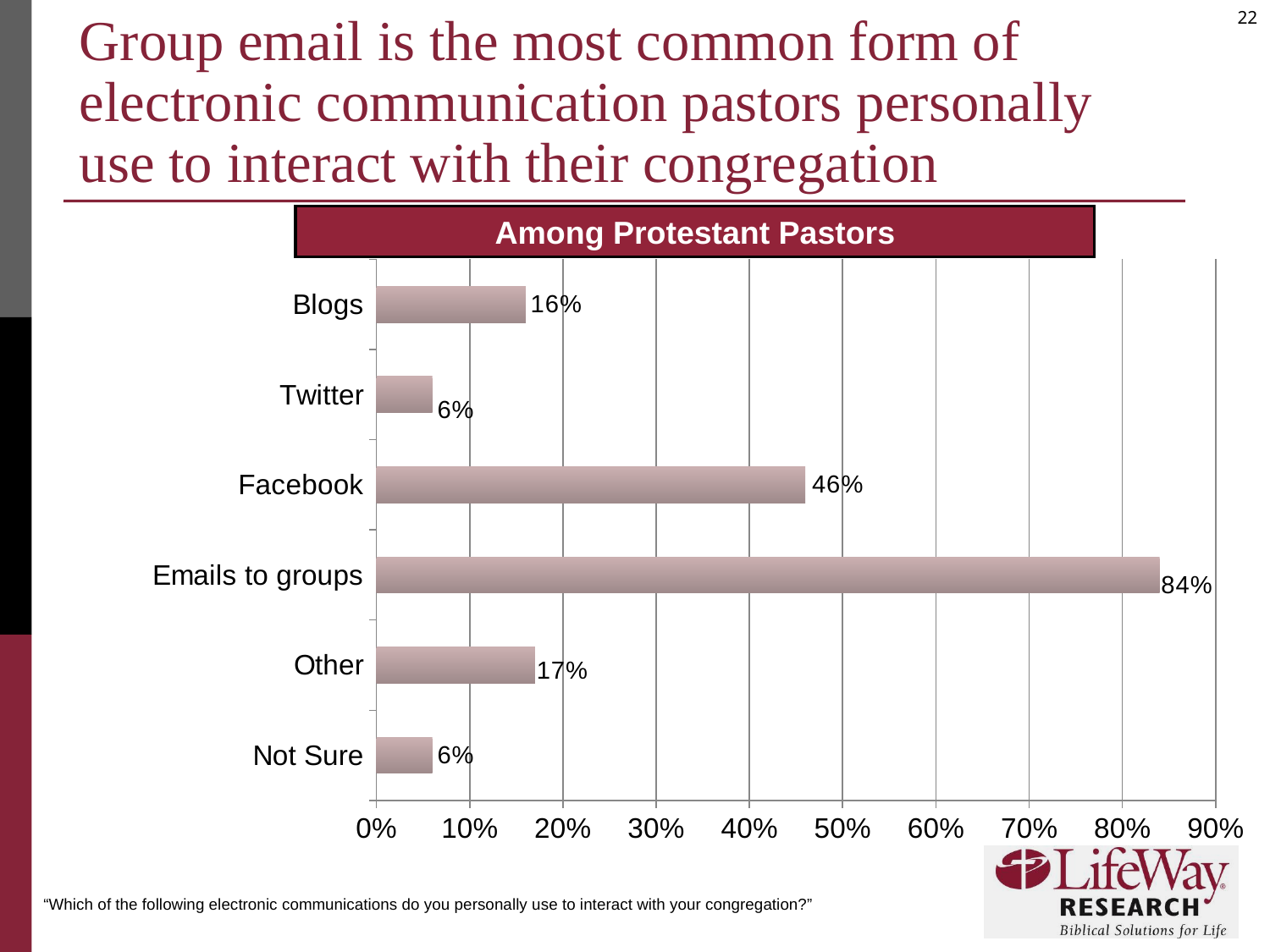
What kind of chart is shown on the slide? Bar chart Which is larger, the value for Facebook or the value for Blogs? Facebook What is the value shown for Blogs? 16% How many categories are shown in the chart? 6 What percentage of Protestant pastors use emails to groups? 84% Is the value for Facebook greater or less than 50%? less What is the title shown above the chart? Among Protestant Pastors What is the value shown for Facebook? 46% Which category has the highest value? Emails to groups What is the difference between the values for Other and Blogs? 1% What is the difference between the values for Emails to groups and Facebook? 38% What is the value shown for Twitter? 6%